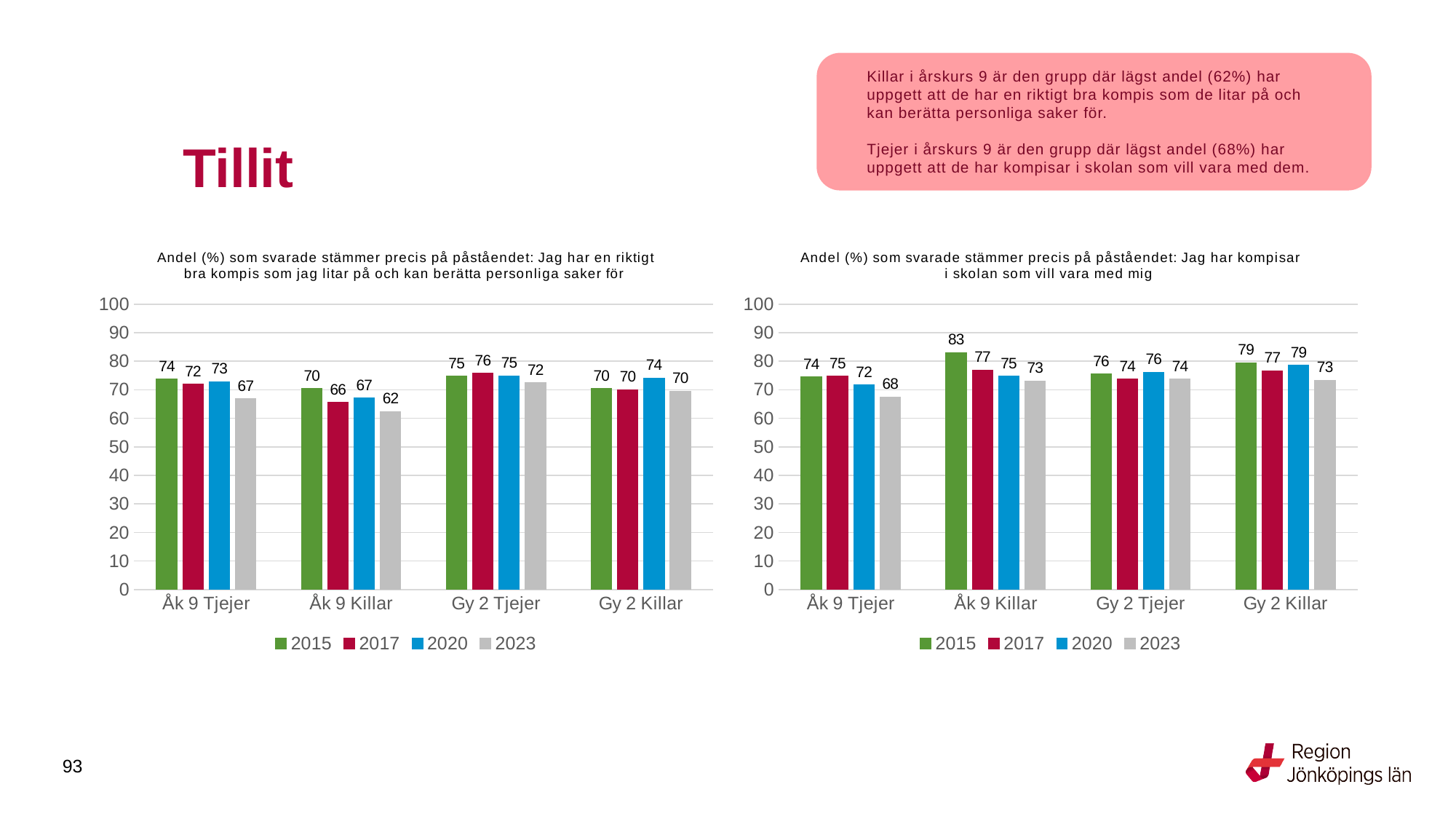
In the left chart (Jag har en riktigt bra kompis...), what is the value for Åk 9 Killar in 2023? 62 In the left chart, which category has the lowest value in 2023? Åk 9 Killar In the left chart, is the value for Åk 9 Killar in 2017 greater or less than 70? less In the right chart, which category has the highest value in 2015? Åk 9 Killar Which colour represents the 2020 series in the legend of the left chart? blue What kind of chart is the right chart? bar chart In the right chart (Jag har kompisar i skolan...), what is the value for Åk 9 Killar in 2015? 83 How many series does the legend of the left chart list? 4 How many categories are shown on the x axis of the right chart? 4 In the right chart, what is the difference between the 2015 and 2023 values for Åk 9 Killar? 10 In the left chart, which is larger for Gy 2 Tjejer: the 2017 value or the 2023 value? 2017 In the right chart, what is the value for Åk 9 Tjejer in 2023? 68